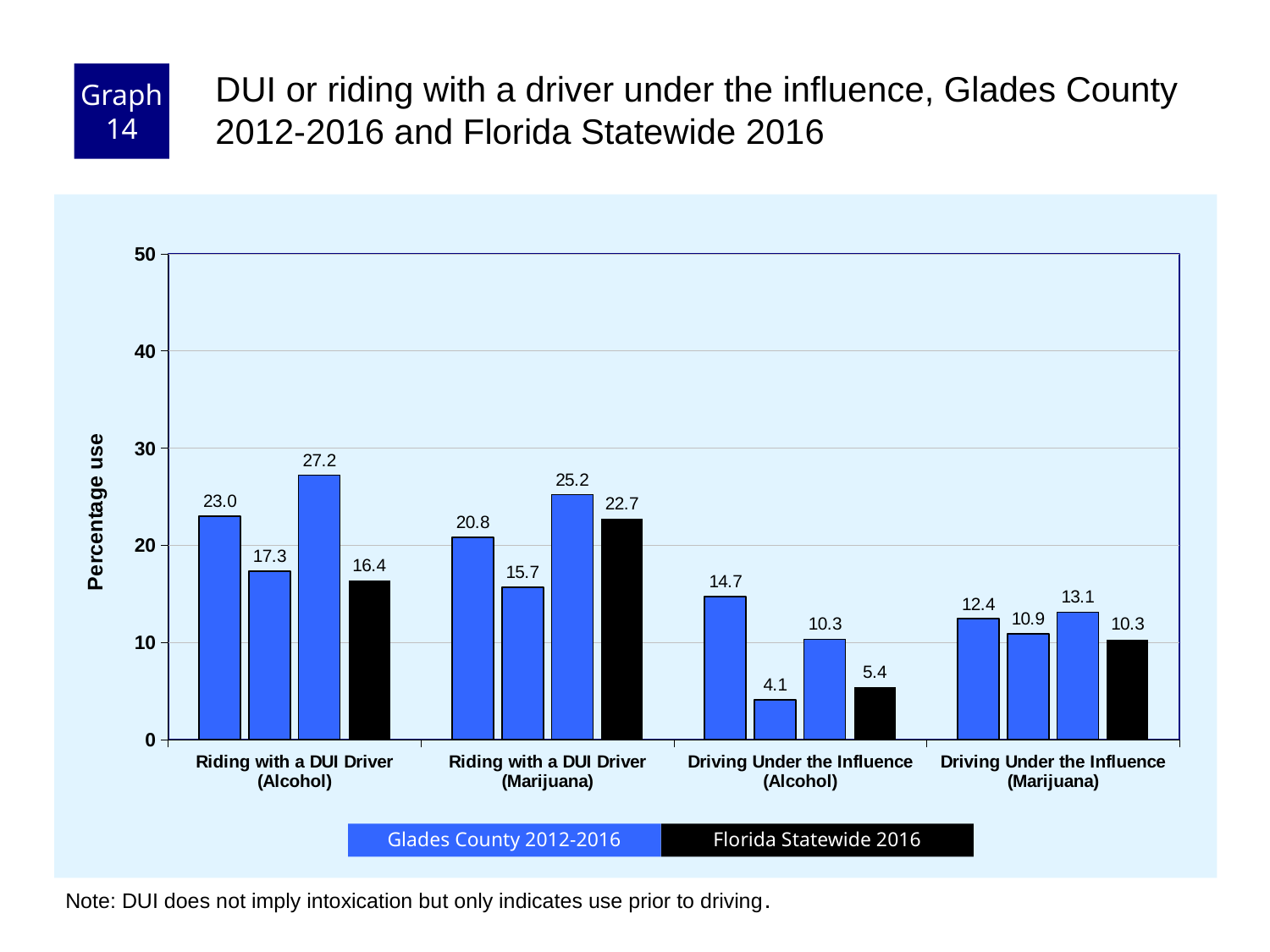
What is the Florida Statewide 2016 value for Riding with a DUI Driver (Alcohol)? 16.4 What is the Florida Statewide 2016 value for Riding with a DUI Driver (Marijuana)? 22.7 Which category has the lowest Florida Statewide 2016 value? Driving Under the Influence (Alcohol) Is the Florida Statewide 2016 value for Driving Under the Influence (Alcohol) greater or less than 10? less How many series does the legend list? 2 Which category has the highest Florida Statewide 2016 value? Riding with a DUI Driver (Marijuana) What is the difference between the Florida Statewide 2016 values for Riding with a DUI Driver (Marijuana) and Riding with a DUI Driver (Alcohol)? 6.3 Which is larger: the Florida Statewide 2016 value for Riding with a DUI Driver (Alcohol) or for Driving Under the Influence (Marijuana)? Riding with a DUI Driver (Alcohol) What is the Florida Statewide 2016 value for Driving Under the Influence (Alcohol)? 5.4 How many categories are shown on the x axis? 4 What kind of chart is shown on the slide? Bar chart What is the value of the first Glades County bar for Driving Under the Influence (Marijuana)? 12.4